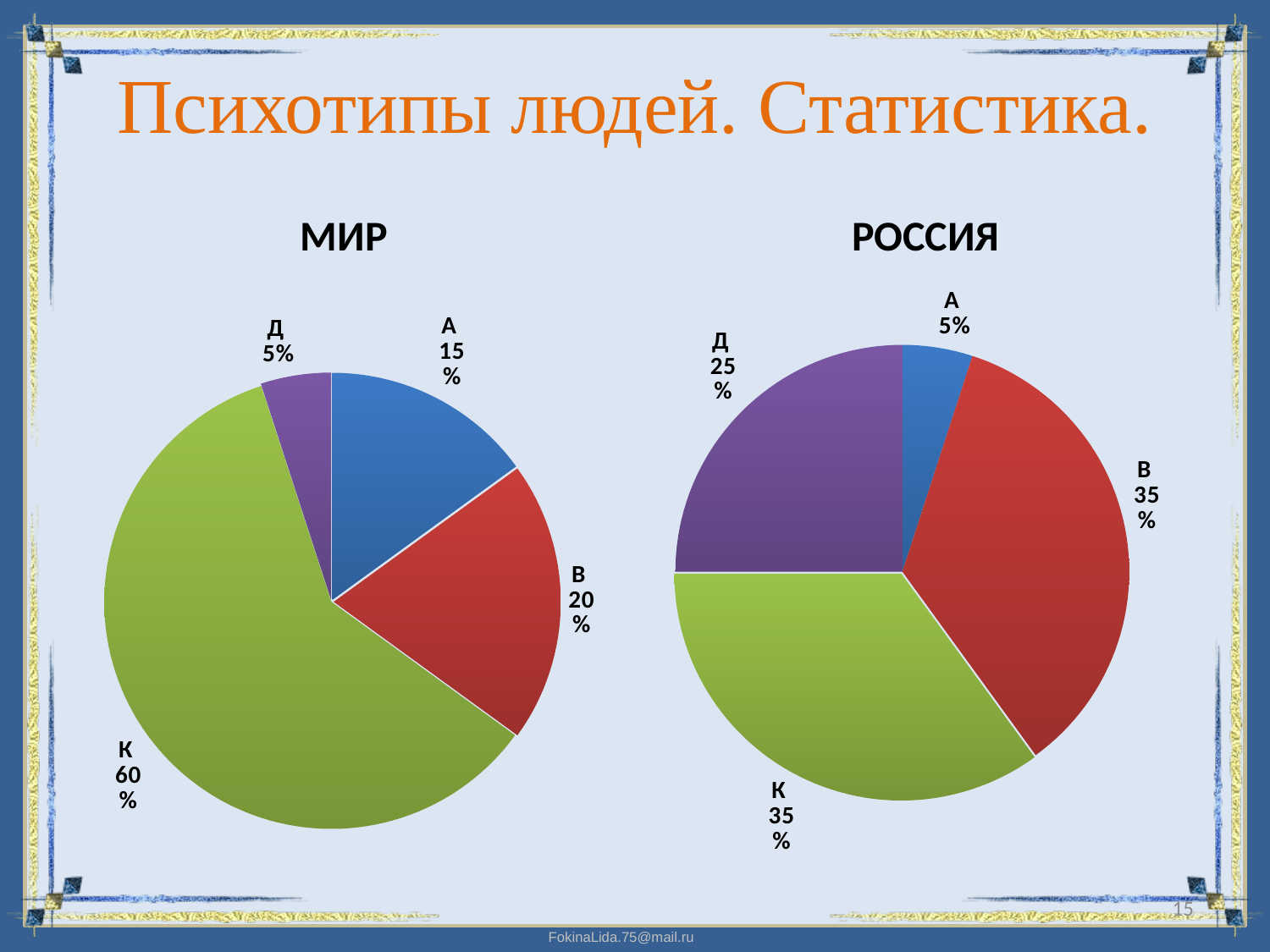
In the МИР chart, which is larger, the value for В or the value for А? В How many slices does the РОССИЯ chart have? 4 In the МИР chart, what is the value for К? 60% In the РОССИЯ chart, what is the value for Д? 25% What kind of chart is the МИР chart? Pie chart In the РОССИЯ chart, what is the difference between the values for Д and А? 20% In the РОССИЯ chart, which category has the smallest slice? А In the РОССИЯ chart, what is the value for В? 35% In the МИР chart, which category has the largest slice? К In the МИР chart, which category has the smallest slice? Д In the МИР chart, what is the difference between the values for К and В? 40% In the МИР chart, what is the value for А? 15%